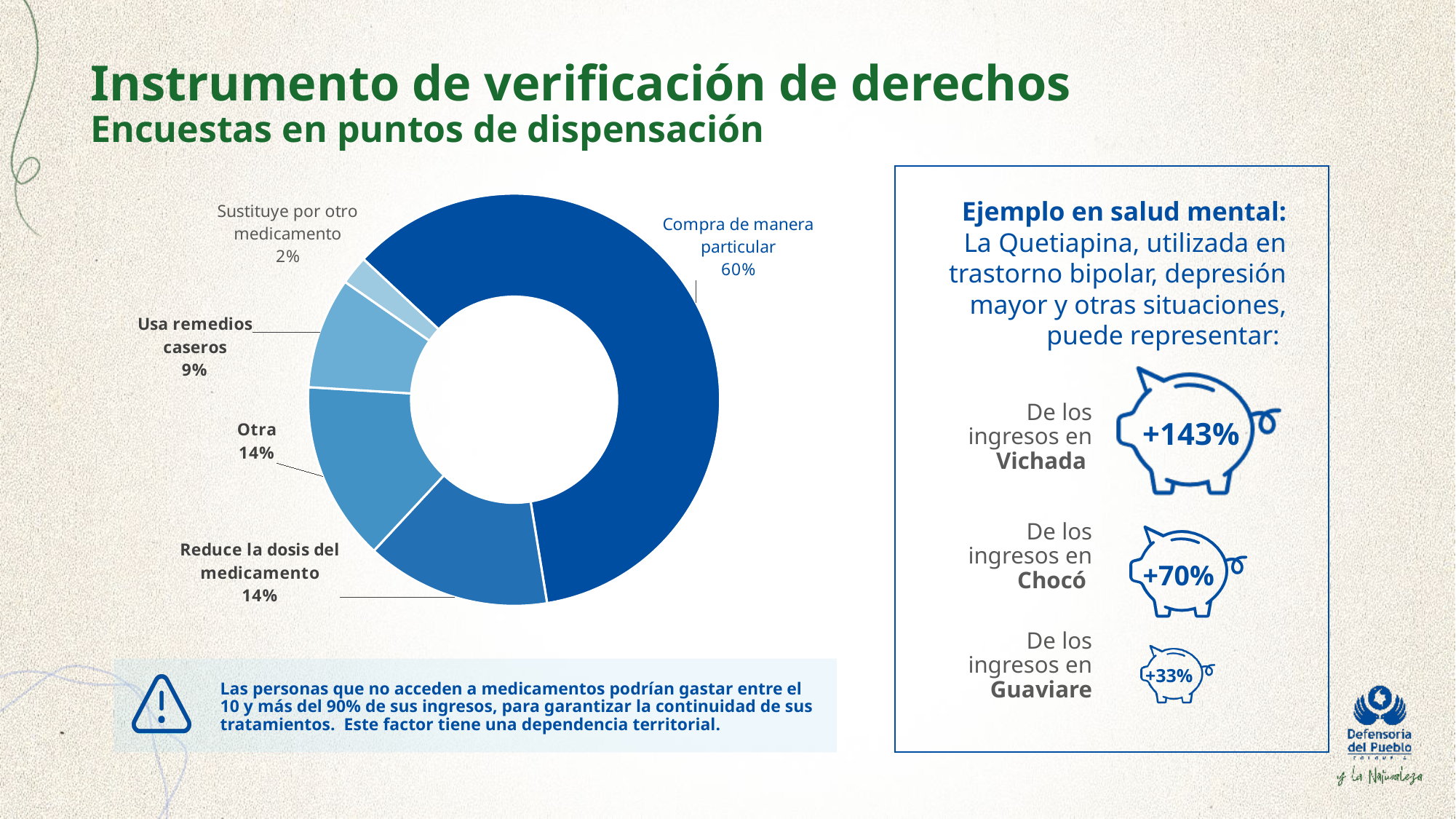
What is the value shown for "Sustituye por otro medicamento"? 2% What kind of chart is shown on the slide? Pie (donut) chart How many categories are shown in the pie chart? 5 Which category has the smallest slice in the pie chart? Sustituye por otro medicamento What is the difference in percentage points between "Usa remedios caseros" and "Sustituye por otro medicamento"? 7 What share does "Usa remedios caseros" have in the pie chart? 9% Which category has the largest slice in the pie chart? Compra de manera particular What percentage of the pie chart corresponds to "Compra de manera particular"? 60% What is the difference in percentage points between "Compra de manera particular" and "Otra"? 46 What percentage increase in income is shown for Vichada in the box on the right? +143% Which is larger, the slice for "Usa remedios caseros" or the slice for "Otra"? Otra What percentage is shown for "Reduce la dosis del medicamento"? 14%